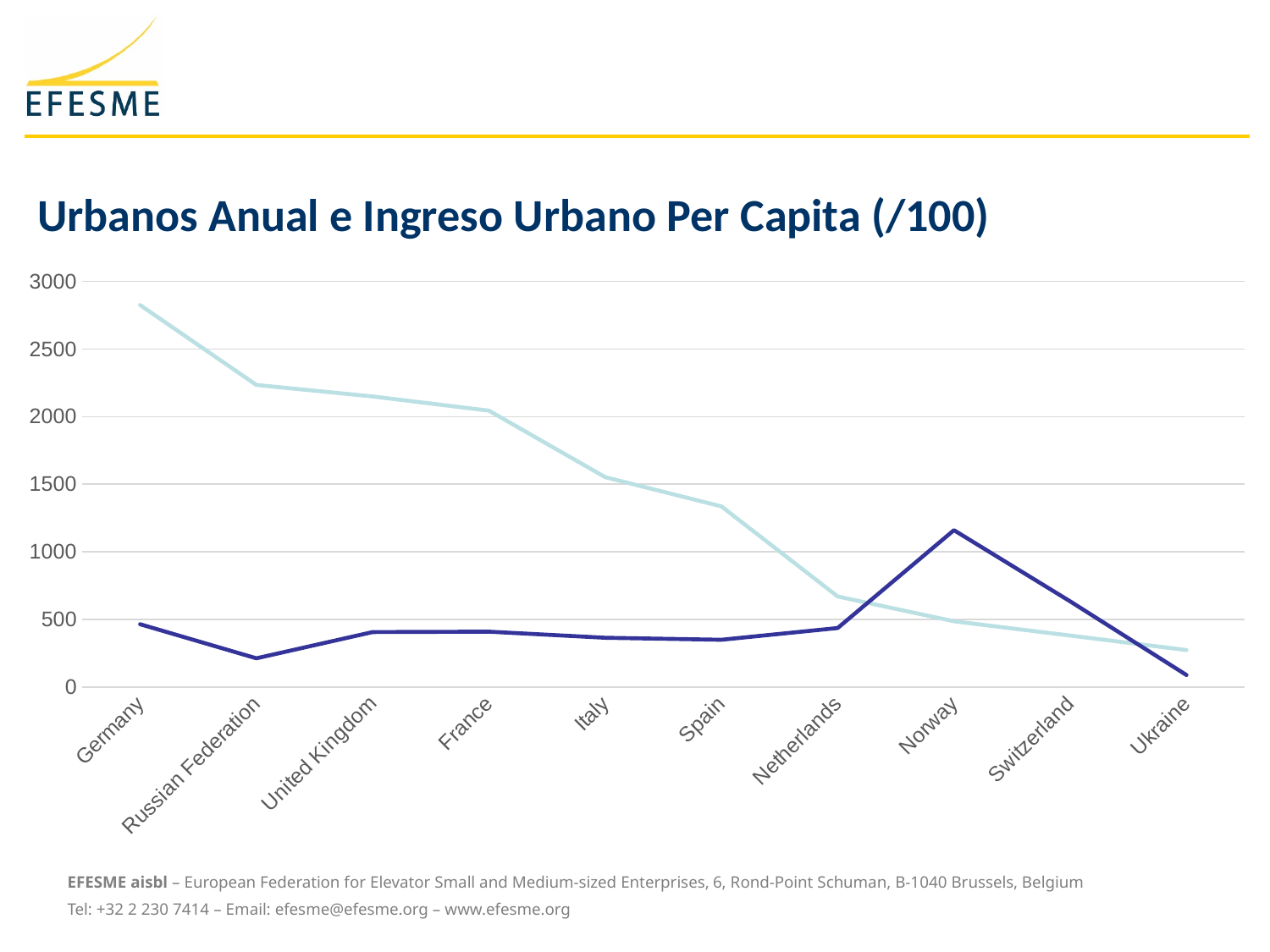
Is the value of the dark blue line for Norway greater or less than 1000? greater For which country does the dark blue line reach its highest value? Norway Does the light blue line generally rise or fall from Germany to Ukraine? fall For which country does the dark blue line reach its lowest value? Ukraine What is the title of the chart? Urbanos Anual e Ingreso Urbano Per Capita (/100) How many lines are plotted on the chart? 2 What kind of chart is shown on the slide? line chart Is the value of the dark blue line for Russian Federation greater or less than 500? less Is the value of the light blue line for Germany greater or less than 2500? greater How many countries are shown along the x axis of the chart? 10 For which country does the light blue line reach its highest value? Germany